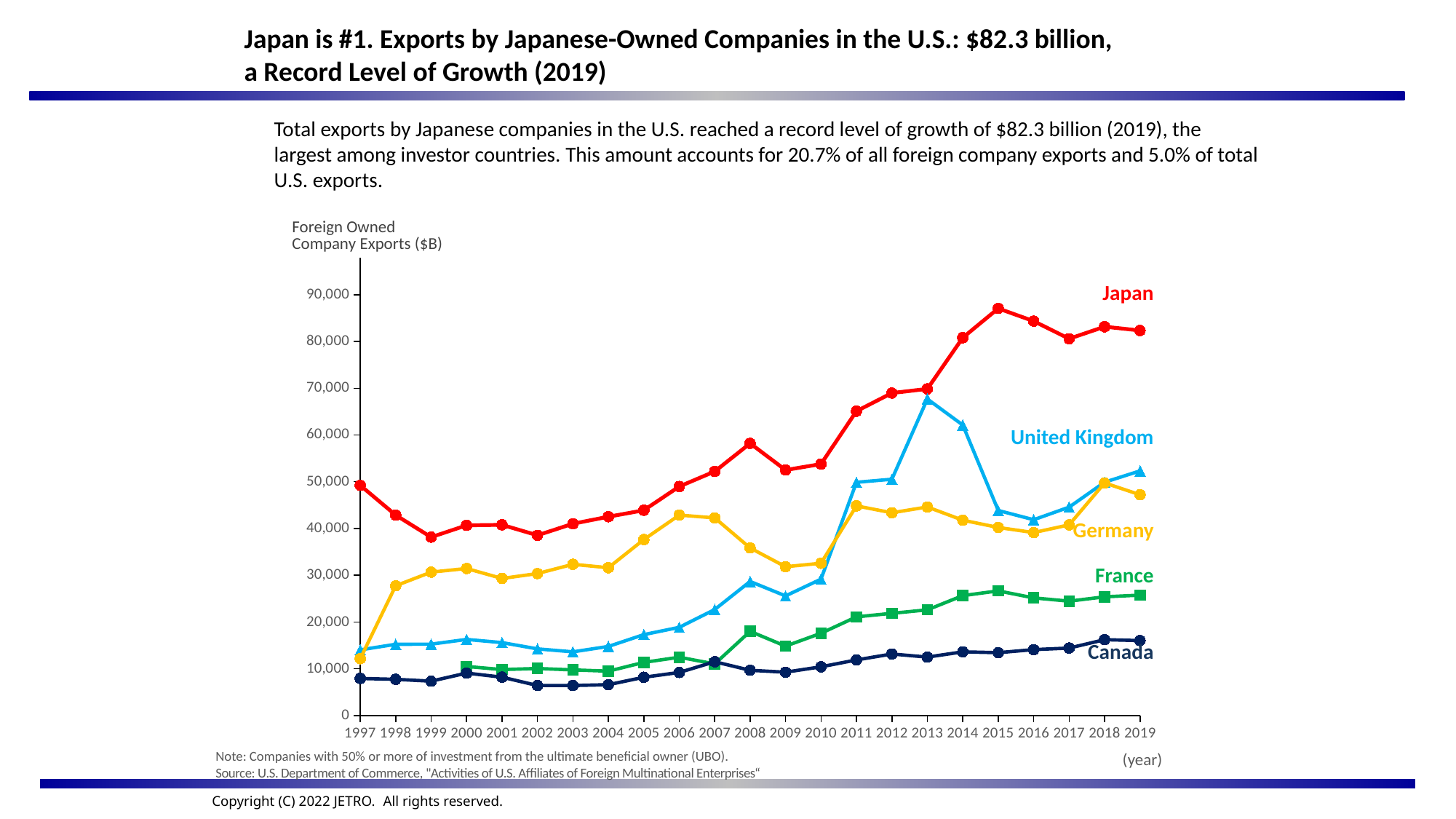
Which country has the highest value in 2019? Japan How many series (countries) are plotted on the chart? 5 How many years are shown along the x axis of the chart? 23 In which year does the Japan line reach its highest point? 2015 What kind of chart is shown on the slide? line chart Which country has the lowest value in 2019? Canada Does the Japan line rise or fall between 2010 and 2015? rise Is the value for Japan in 2015 greater or less than 80,000? greater Is the value for the United Kingdom in 2013 greater or less than 60,000? greater Is the value for France in 2015 greater or less than 20,000? greater What is the label on the y axis of the chart? Foreign Owned Company Exports ($B) Which is larger in 2005, the value for Germany or the value for the United Kingdom? Germany